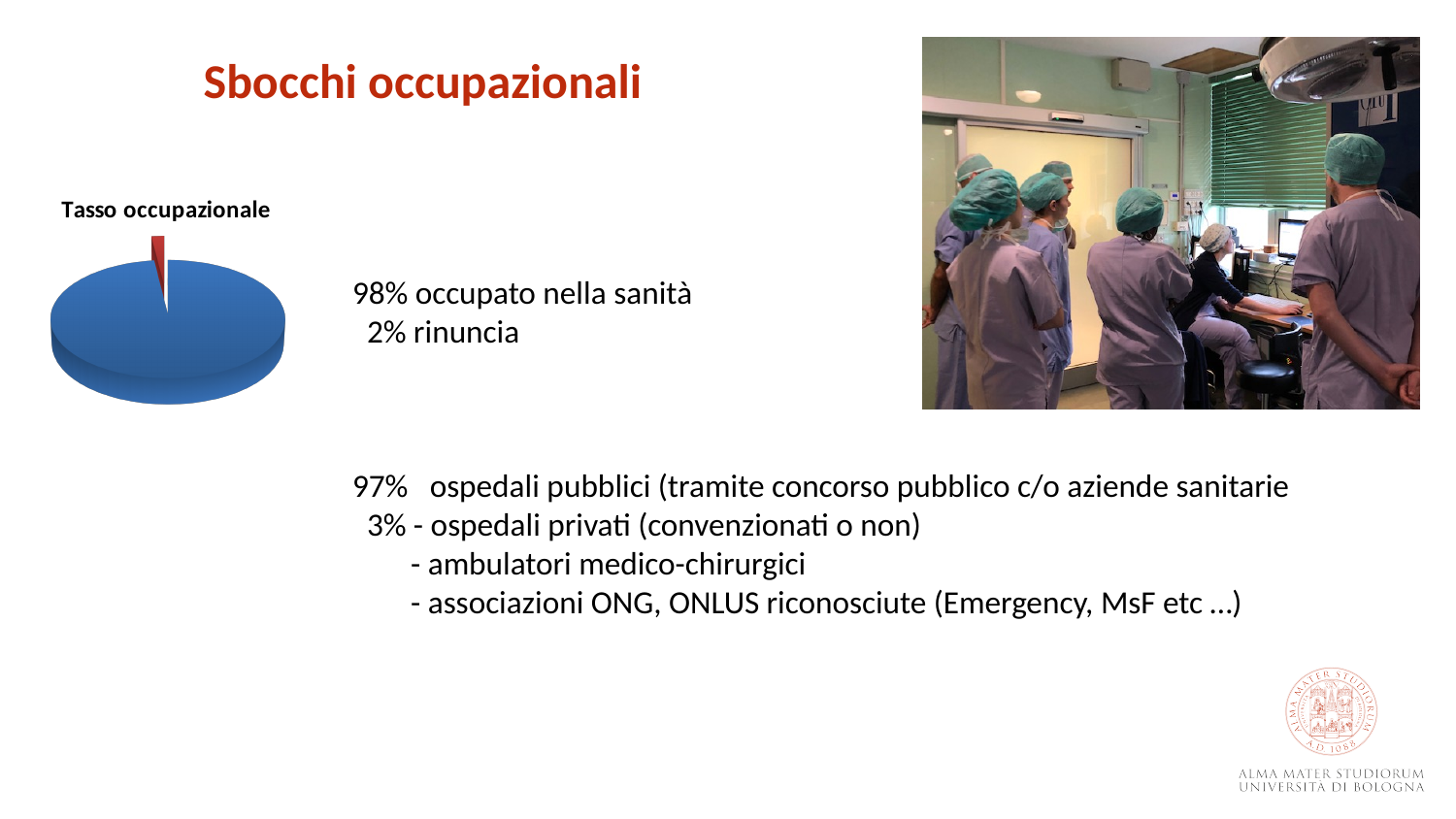
What is the title of the chart on the slide? Tasso occupazionale How many slices does the pie chart have? 2 According to the slide, what share of the pie chart corresponds to "rinuncia"? 2% What kind of chart is shown under the heading "Tasso occupazionale"? pie chart Is the share of the large blue slice in the pie chart greater or less than 50%? greater According to the slide, what share of the pie chart corresponds to "occupato nella sanità"? 98% Does the pie chart display a legend? No Which slice of the pie chart is larger, the blue one or the red one? the blue one Which colour is the smallest slice of the pie chart? red